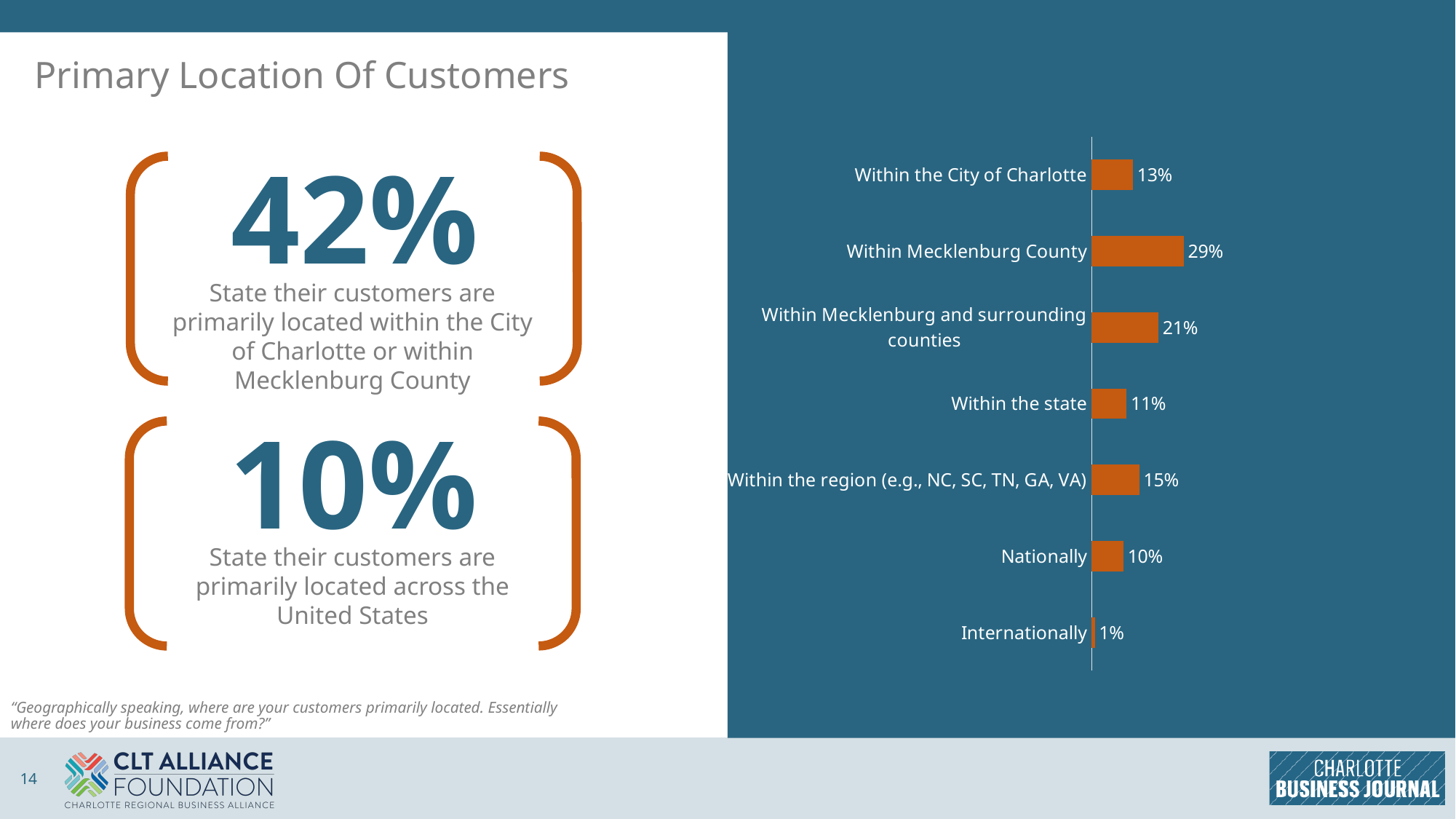
What is the value for 'Within the region (e.g., NC, SC, TN, GA, VA)'? 15% Which is larger: 'Within the state' or 'Within the region (e.g., NC, SC, TN, GA, VA)'? Within the region (e.g., NC, SC, TN, GA, VA) What is the value for 'Within the City of Charlotte'? 13% What kind of chart is shown on the slide? Bar chart Which category has the lowest value? Internationally Which category has the highest value? Within Mecklenburg County What is the difference between 'Within Mecklenburg County' and 'Within Mecklenburg and surrounding counties'? 8% How many categories are shown in the chart? 7 What is the value for 'Nationally'? 10% What is the combined value of 'Within the City of Charlotte' and 'Within Mecklenburg County'? 42% What percentage of respondents say their customers are primarily located within Mecklenburg County? 29% What is the title of the slide containing the chart? Primary Location Of Customers